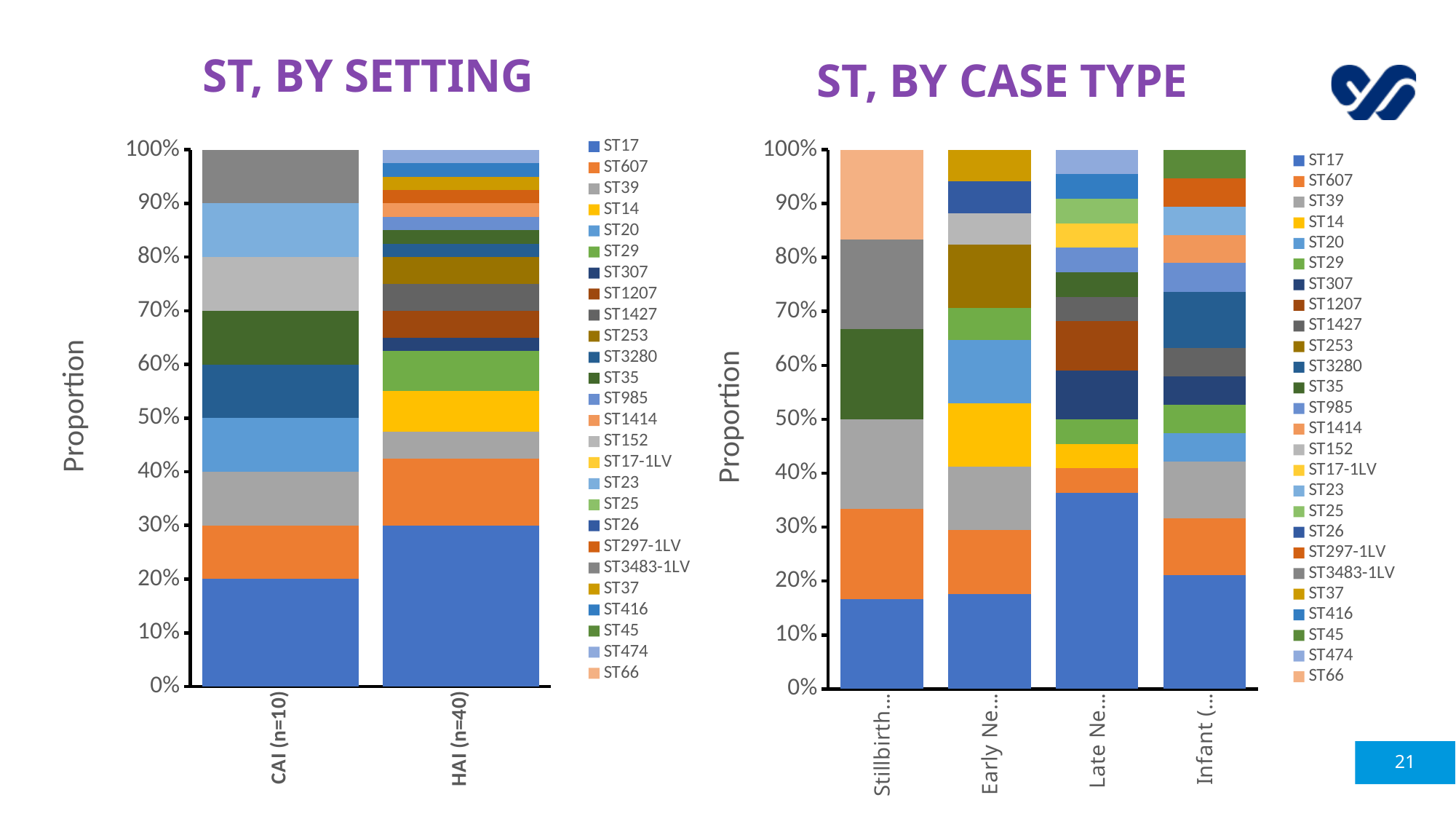
In the 'ST, BY SETTING' chart, what proportion does ST17 make up of the CAI (n=10) bar? 20% In the 'ST, BY CASE TYPE' chart, is the ST17 proportion for the 'Stillbirth...' bar greater or less than 20%? less How many categories are shown on the x axis of the 'ST, BY CASE TYPE' chart? 4 In the 'ST, BY CASE TYPE' chart, is the ST17 proportion for the 'Late Ne...' bar greater or less than 30%? greater How many categories are shown on the x axis of the 'ST, BY SETTING' chart? 2 In the 'ST, BY CASE TYPE' chart, is the ST17 proportion larger for the 'Late Ne...' bar or the 'Stillbirth...' bar? Late Ne... How many series does the legend of the 'ST, BY CASE TYPE' chart list? 26 What is the y-axis title of the 'ST, BY SETTING' chart? Proportion What kind of chart is the 'ST, BY SETTING' chart? Stacked bar chart In the 'ST, BY SETTING' chart, is the ST17 proportion for HAI (n=40) greater or less than 20%? greater In the 'ST, BY SETTING' chart, is the ST17 proportion larger for CAI (n=10) or HAI (n=40)? HAI (n=40) What is the first entry in the legend of the 'ST, BY SETTING' chart? ST17